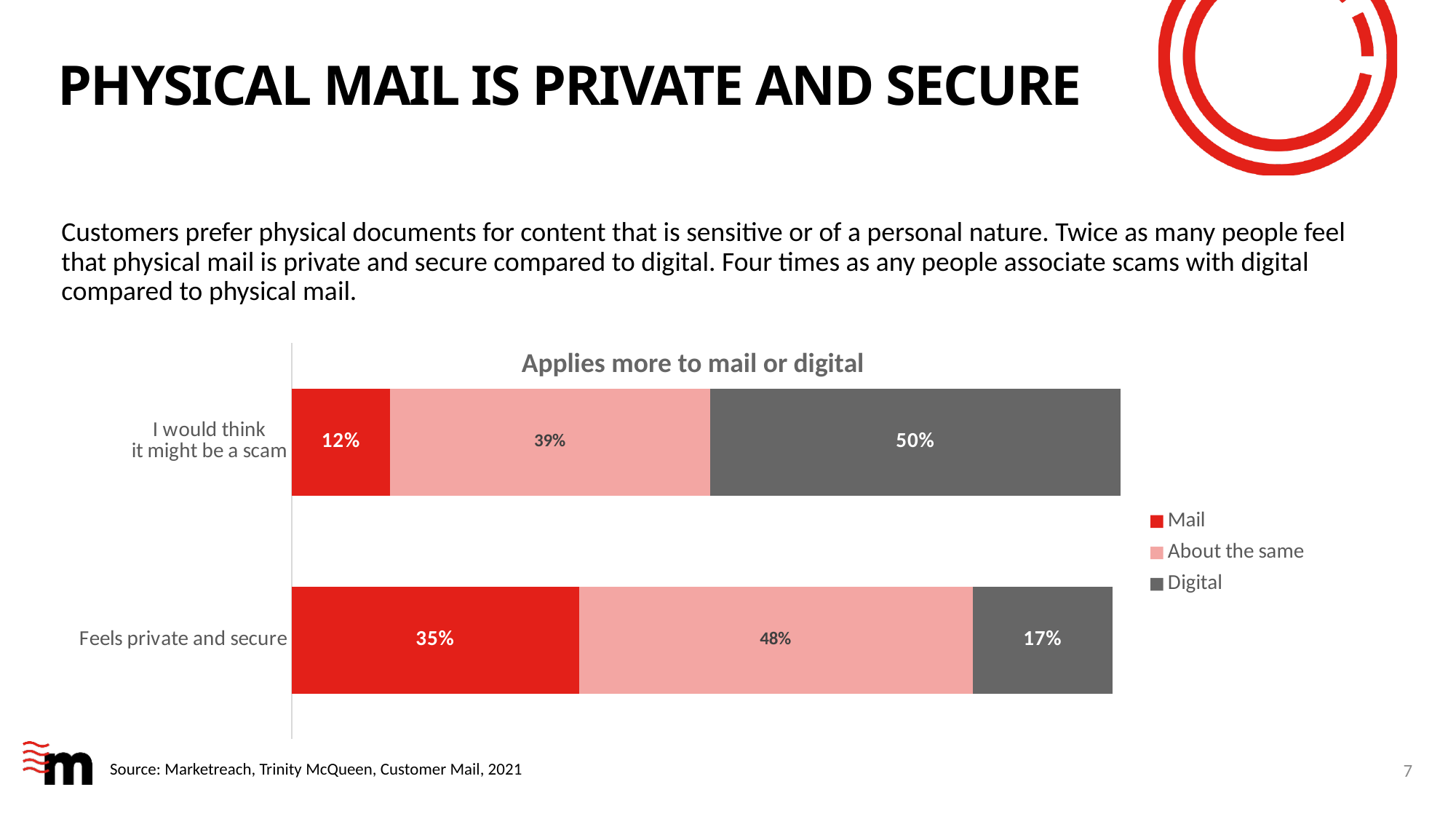
Which series has the lowest value in the 'Feels private and secure' category? Digital What is the value for Mail in the 'I would think it might be a scam' category? 12% What is the title of the chart? Applies more to mail or digital What kind of chart is shown on the slide? Stacked bar chart What is the value for Digital in the 'I would think it might be a scam' category? 50% Which series has the highest value in the 'I would think it might be a scam' category? Digital How many categories are shown on the chart? 2 How many series does the legend list? 3 Which is larger: the Mail value for 'Feels private and secure' or the Mail value for 'I would think it might be a scam'? Feels private and secure What is the value for Mail in the 'Feels private and secure' category? 35% What is the difference between the Digital values for 'I would think it might be a scam' and 'Feels private and secure'? 33 percentage points What is the value for 'About the same' in the 'Feels private and secure' category? 48%